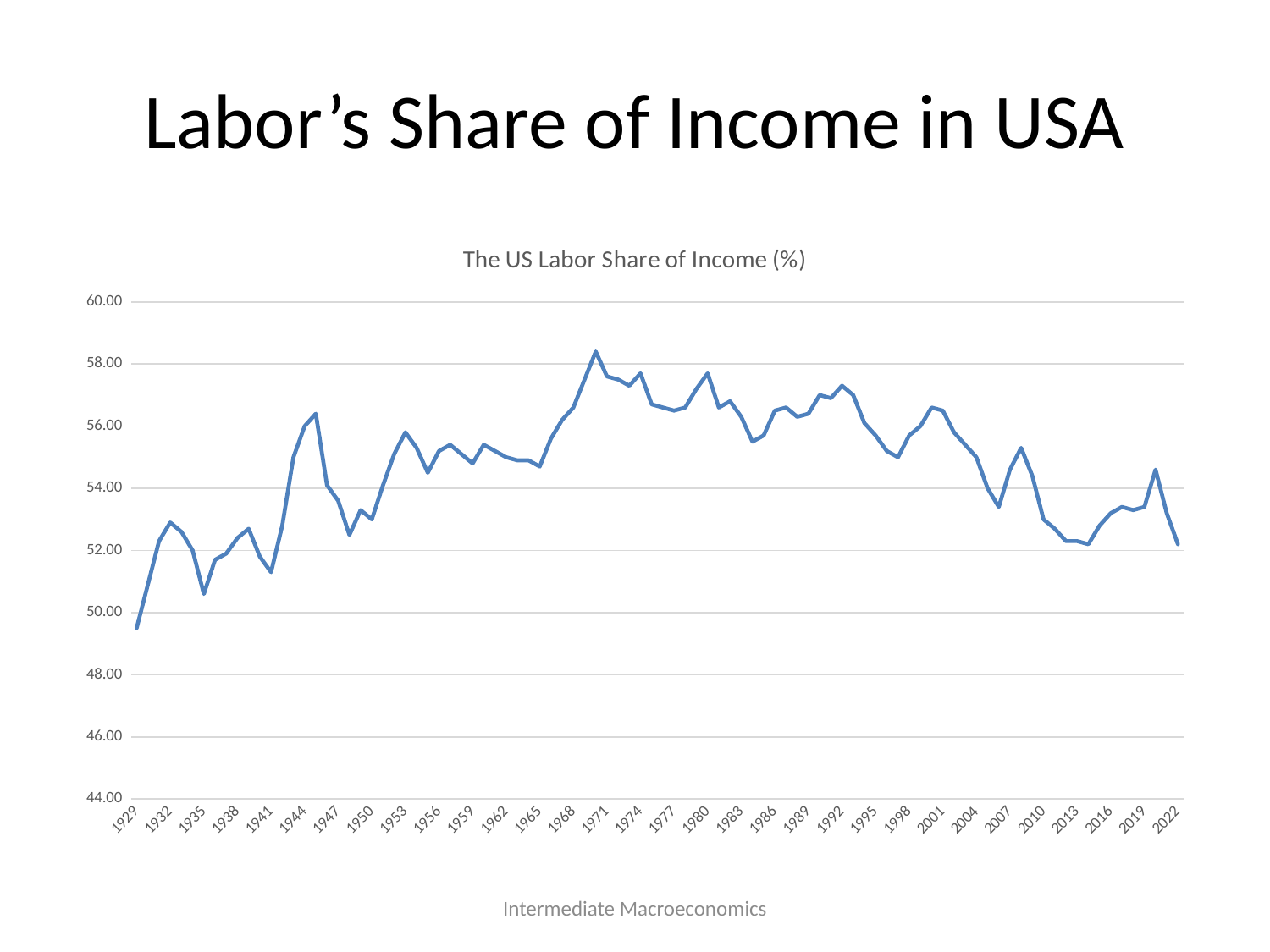
Which year on the x axis has the lowest labor share of income? 1929 Is the value for 1980 greater or less than 56.00? greater Which is larger, the value for 1929 or the value for 2022? 2022 Is the value for 1929 greater or less than 50.00? less Is the value for 1953 greater or less than 54.00? greater Which is larger, the value for 1971 or the value for 2022? 1971 What is the title of the chart? The US Labor Share of Income (%) Does the labor share of income generally rise or fall from 1992 to 2022? fall What kind of chart is shown on the slide? line chart